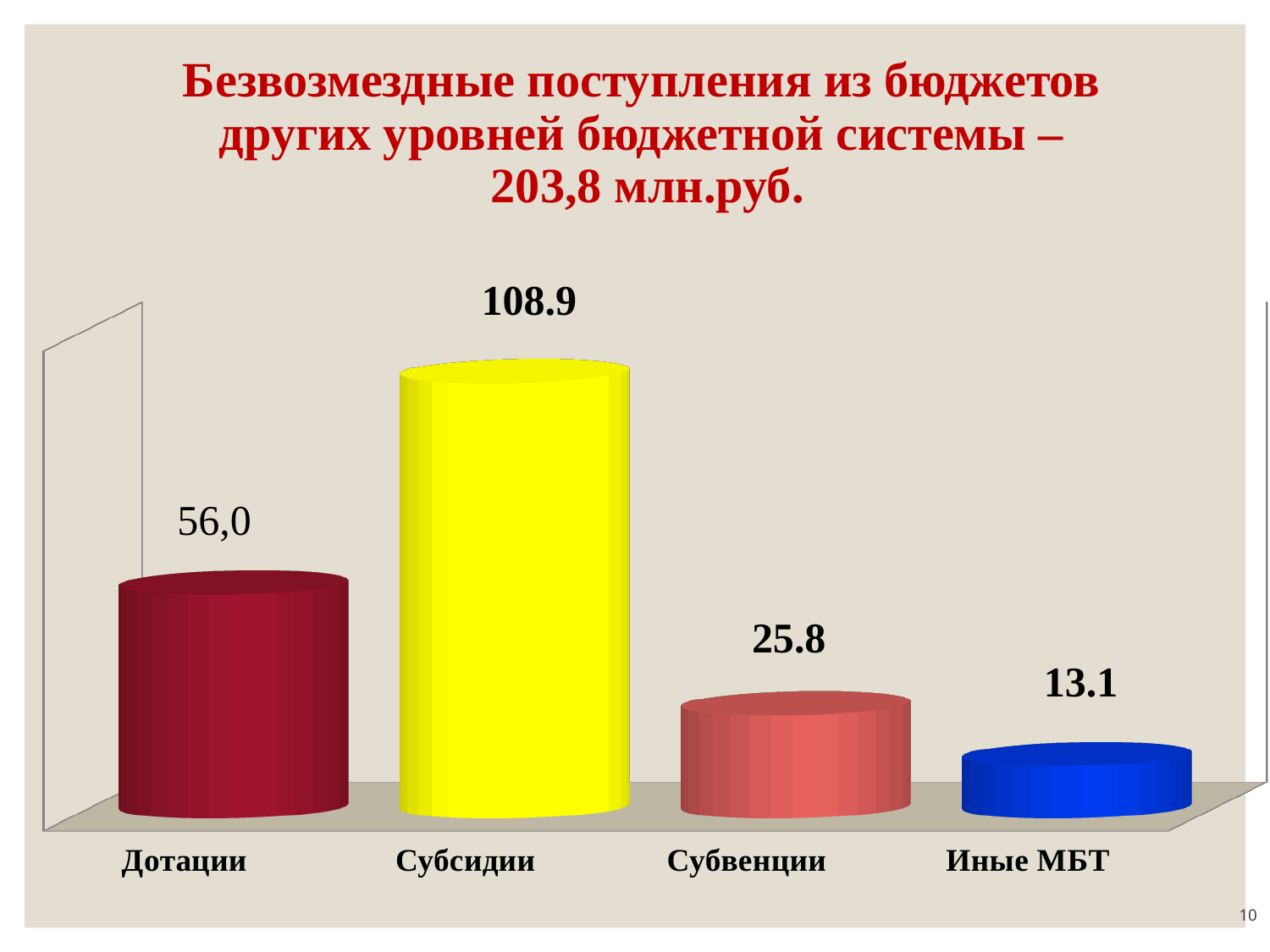
Which category has the lowest value? Иные МБТ What is the difference between the values for Субвенции and Иные МБТ? 12.7 What is the difference between the values for Субсидии and Дотации? 52.9 What is the value shown for Иные МБТ? 13.1 Which is larger, the value for Дотации or the value for Субвенции? Дотации What is the value shown for Дотации? 56,0 What is the value shown for Субвенции? 25.8 Which category has the highest value? Субсидии How many categories are shown in the chart? 4 What is the value shown for Субсидии? 108.9 What total amount in млн.руб. is stated in the chart title? 203,8 млн.руб. What kind of chart is shown on the slide? Bar chart